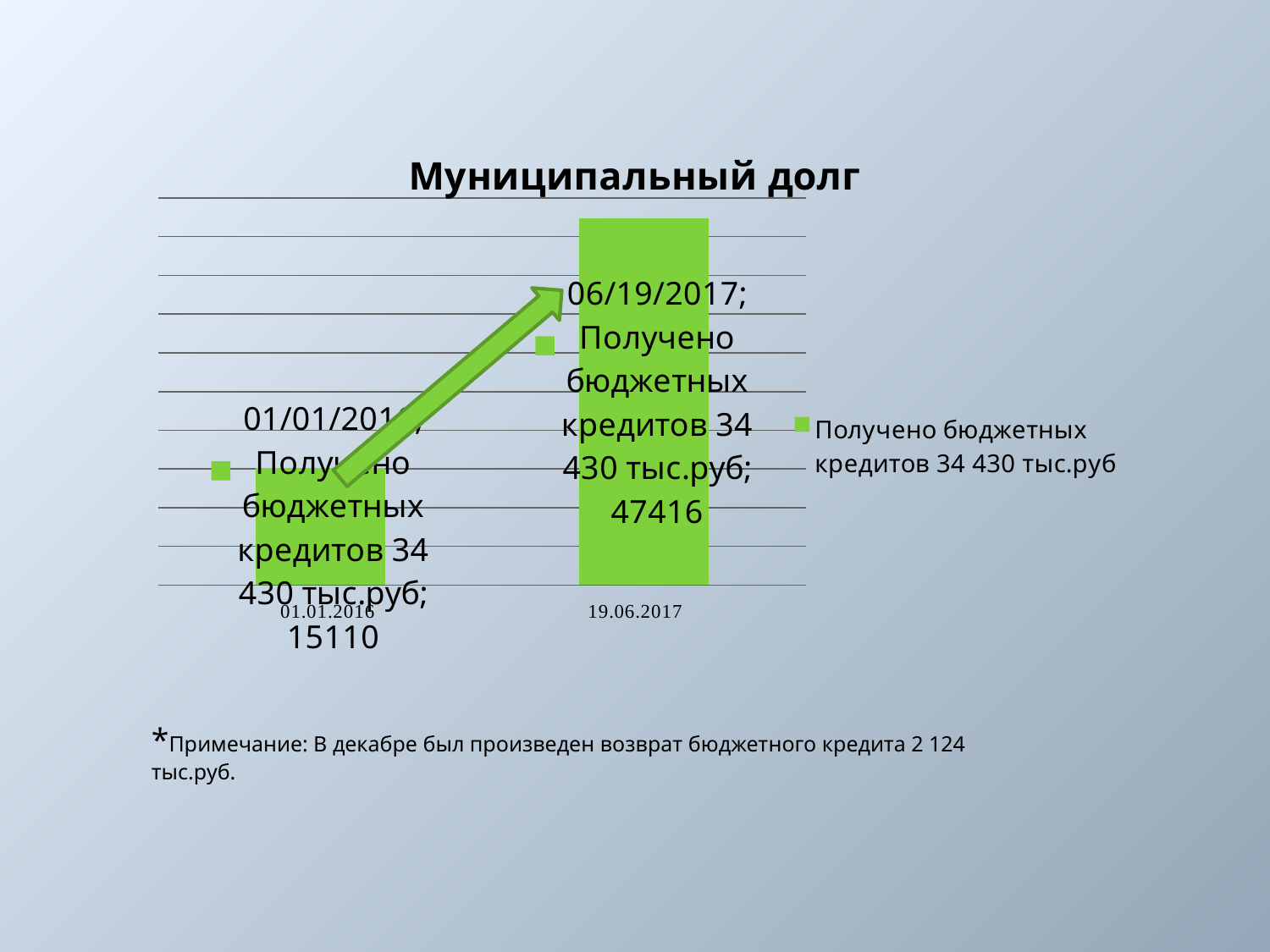
How many bars are plotted in the chart? 2 Which date has the lowest value? 01.01.2016 What is the value for 01.01.2016? 15110 What type of chart is shown on the slide? bar chart What is the value for 19.06.2017? 47416 What is the legend entry of the series? Получено бюджетных кредитов 34 430 тыс.руб What is the difference between the values for 19.06.2017 and 01.01.2016? 32306 Which date has the highest value? 19.06.2017 Which is larger, the value for 01.01.2016 or the value for 19.06.2017? 19.06.2017 What is the title of the chart? Муниципальный долг How many series does the legend list? 1 Do the values rise or fall from 01.01.2016 to 19.06.2017? rise